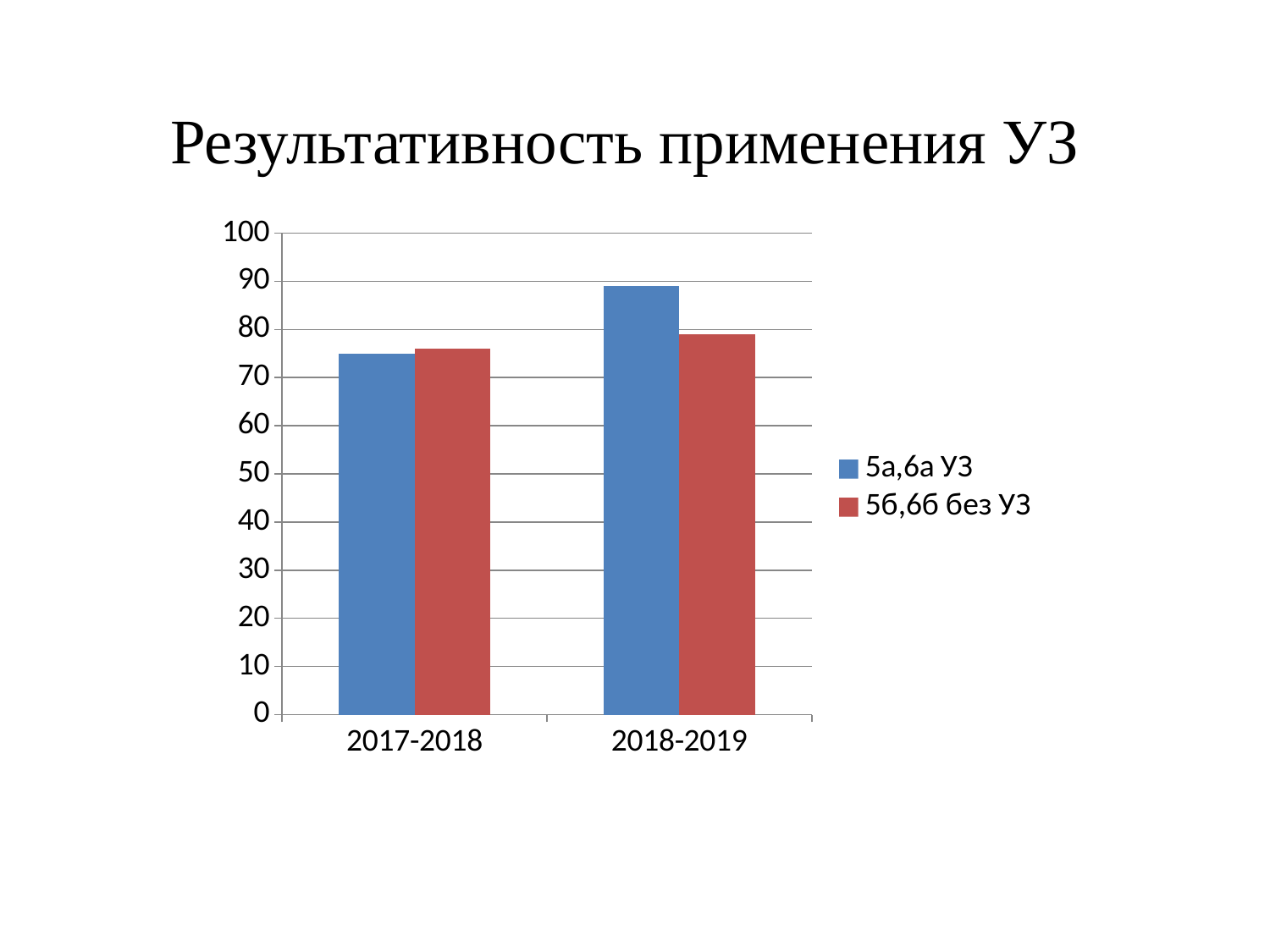
Is the value for 5б,6б без УЗ in 2018-2019 greater or less than 70? greater How many categories are shown on the x axis? 2 In 2018-2019, which series has the larger value, 5а,6а УЗ or 5б,6б без УЗ? 5а,6а УЗ How many series does the legend list? 2 Is the value for 5а,6а УЗ in 2018-2019 greater or less than 80? greater What is the title of the slide above the chart? Результативность применения УЗ Is the value for 5а,6а УЗ in 2017-2018 greater or less than 70? greater Does the value for 5а,6а УЗ rise or fall from 2017-2018 to 2018-2019? rise What kind of chart is shown on the slide? bar chart Which series is shown in blue? 5а,6а УЗ